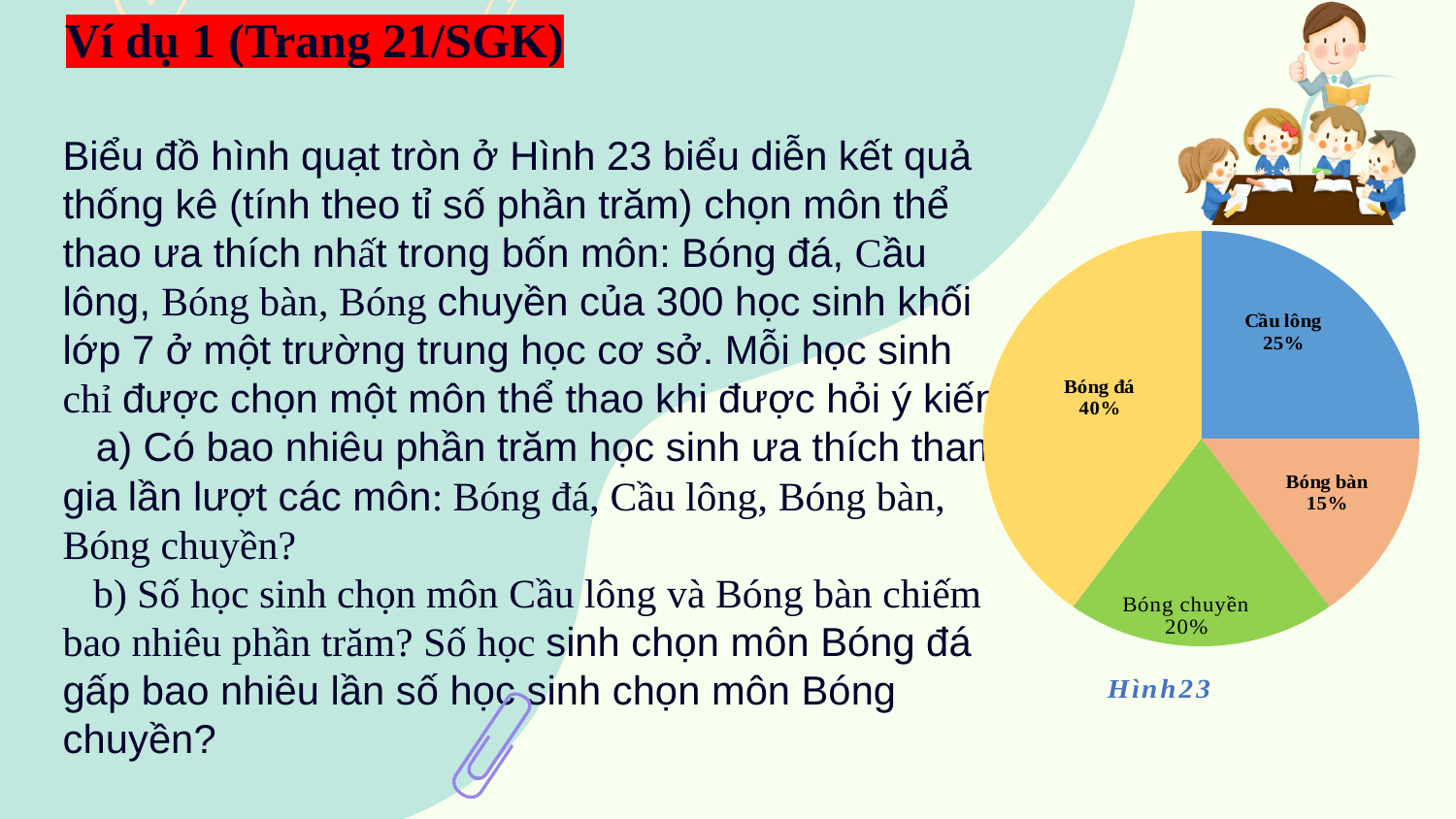
What is the difference in percentage points between Bóng đá and Bóng chuyền? 20 How many slices does the pie chart have? 4 Which slice is larger, Cầu lông or Bóng chuyền? Cầu lông What percentage of the pie chart is Bóng bàn? 15% What is the caption printed below the pie chart? Hình23 What percentage of the pie chart is Cầu lông? 25% What kind of chart is shown on the slide? pie chart Which sport has the largest slice in the pie chart? Bóng đá What is the combined percentage of Cầu lông and Bóng bàn? 40% What percentage of the pie chart is Bóng chuyền? 20% Which sport has the smallest slice in the pie chart? Bóng bàn What percentage of the pie chart is Bóng đá? 40%